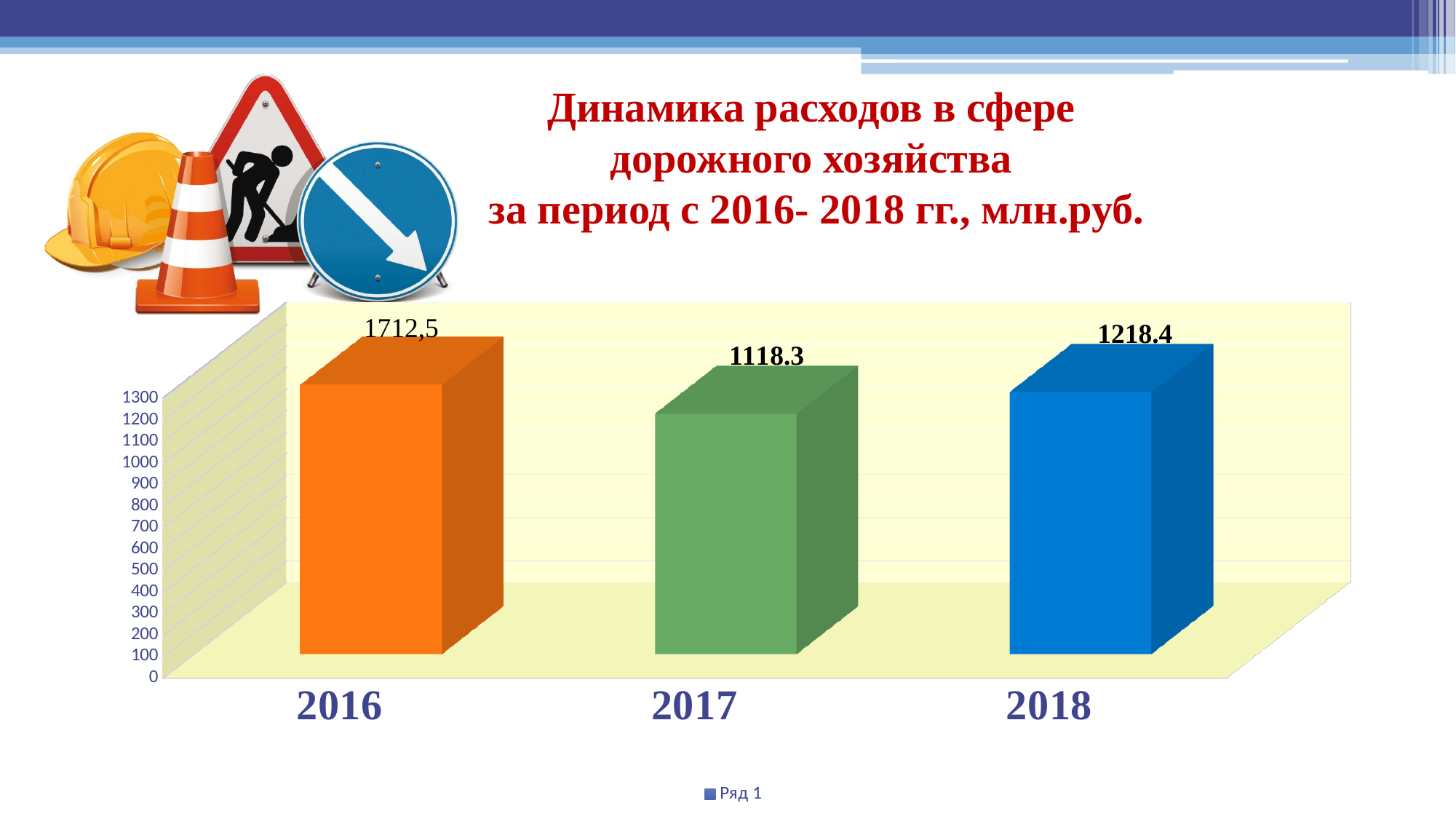
Which year has the lowest value? 2017 What kind of chart is shown on the slide? bar chart Which is larger, the value for 2017 or the value for 2018? 2018 Is the value for 2017 greater or less than 1200? less What is the difference between the values for 2018 and 2017? 100.1 Does the value rise or fall from 2016 to 2017? fall What is the value for 2016? 1712,5 Which year has the highest value? 2016 What is the value for 2017? 1118.3 What is the value for 2018? 1218.4 How many years are shown on the x axis? 3 How many series does the legend list? 1